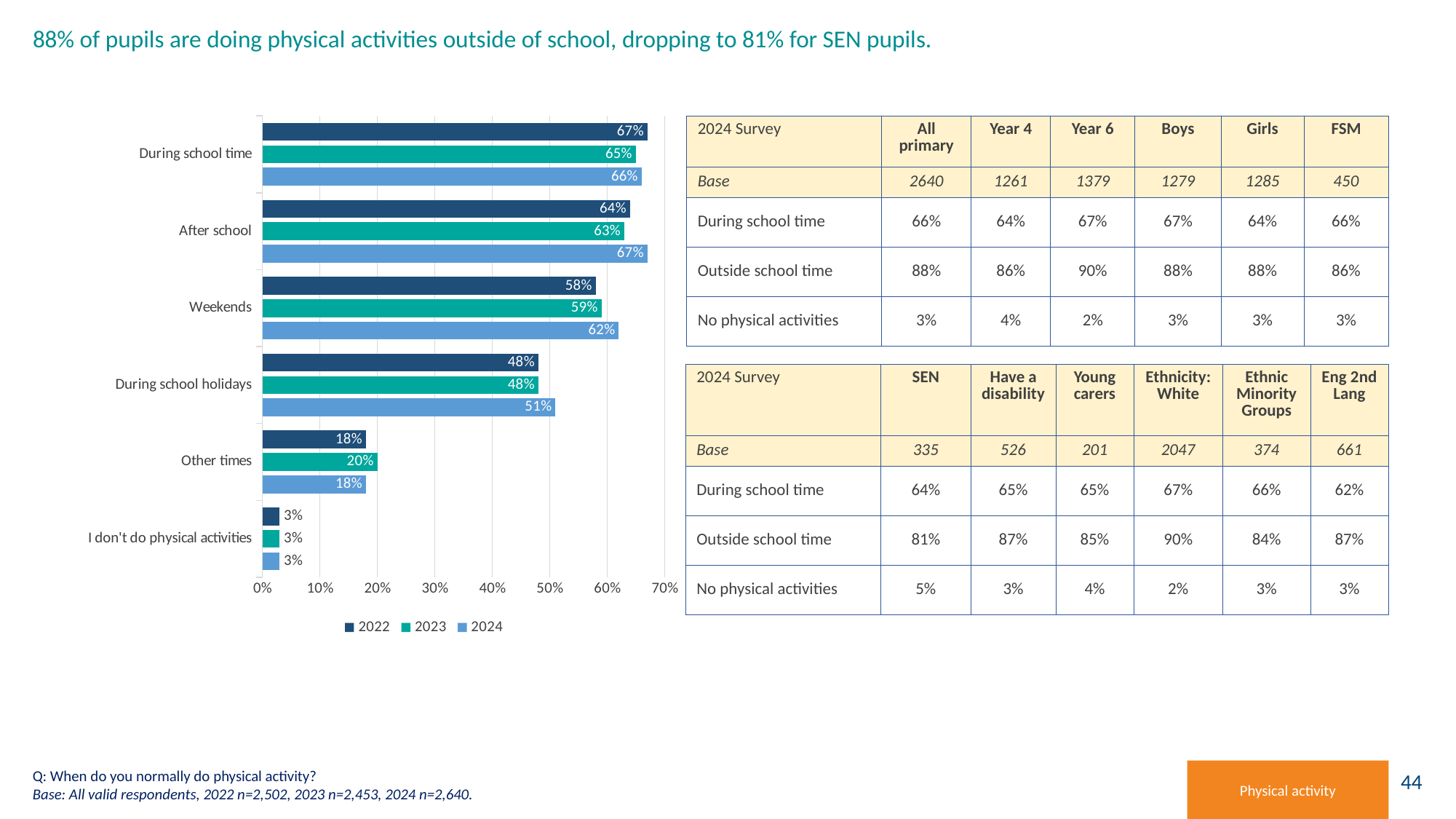
What is the 2022 value for 'After school' in the bar chart? 64% What is the difference between the 2024 and 2023 values for 'After school' in the bar chart? 4% What kind of chart is shown on the slide? Bar chart What is the difference between the 2024 and 2022 values for 'During school holidays' in the bar chart? 3% How many categories are shown on the bar chart? 6 Which category has the lowest values in the bar chart? I don't do physical activities In the bar chart, is the 2023 value for 'During school time' larger or the 2023 value for 'After school'? During school time What is the 2024 value for 'Weekends' in the bar chart? 62% How many series does the bar chart legend list? 3 Which category has the highest 2024 value in the bar chart? After school What is the 2023 value for 'Other times' in the bar chart? 20% Which years are listed in the bar chart legend? 2022, 2023, 2024